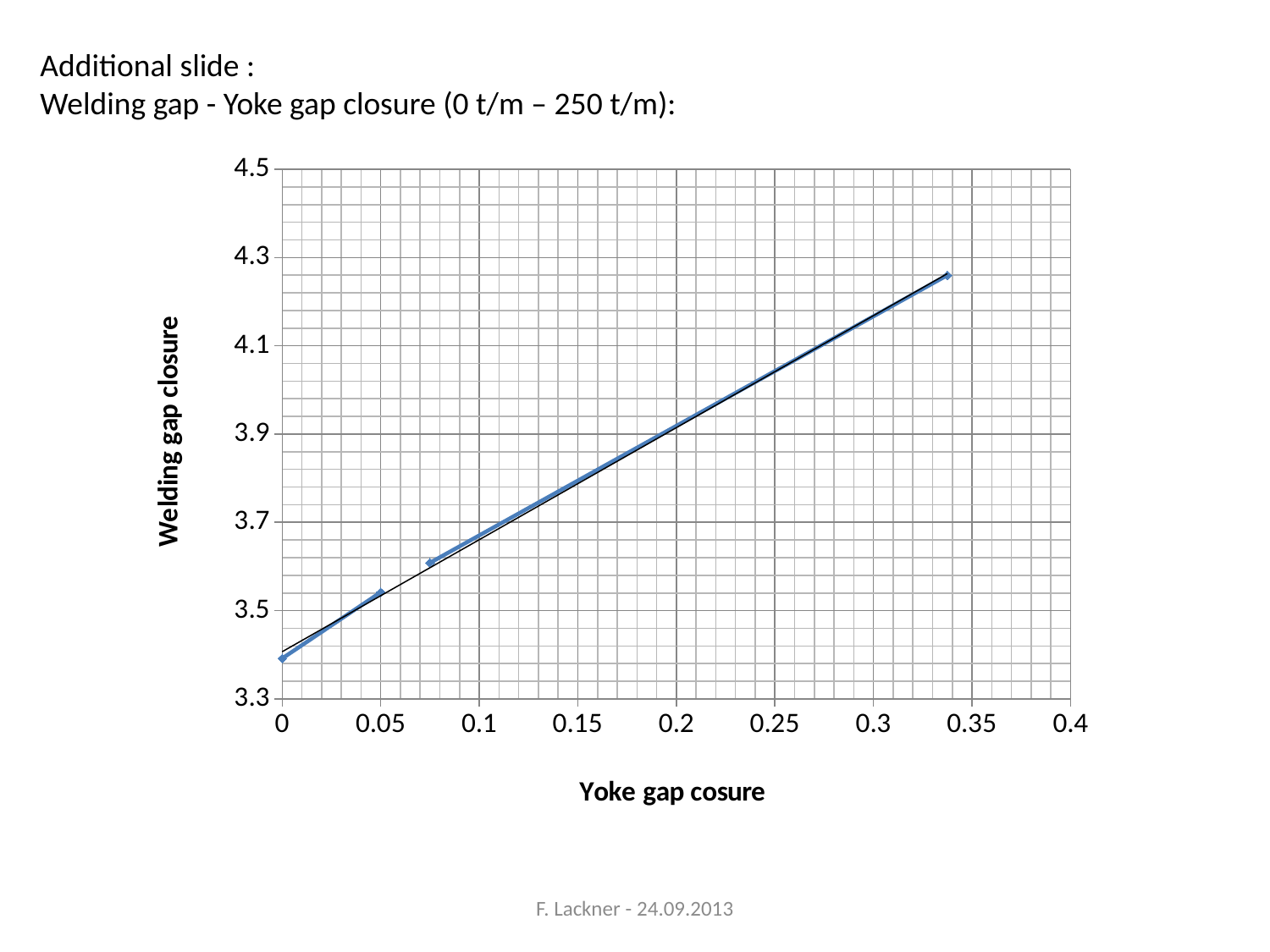
Do the plotted values rise or fall as the yoke gap closure increases along the x axis? rise What is the title of the x axis of the chart? Yoke gap cosure Is the welding gap closure value at a yoke gap closure of 0.05 greater or less than 3.5? greater Is the highest plotted welding gap closure value greater or less than 4.3? less What is the maximum value shown on the x axis of the chart? 0.4 Is the welding gap closure value at a yoke gap closure of 0 greater or less than 3.5? less What is the title of the y axis of the chart? Welding gap closure